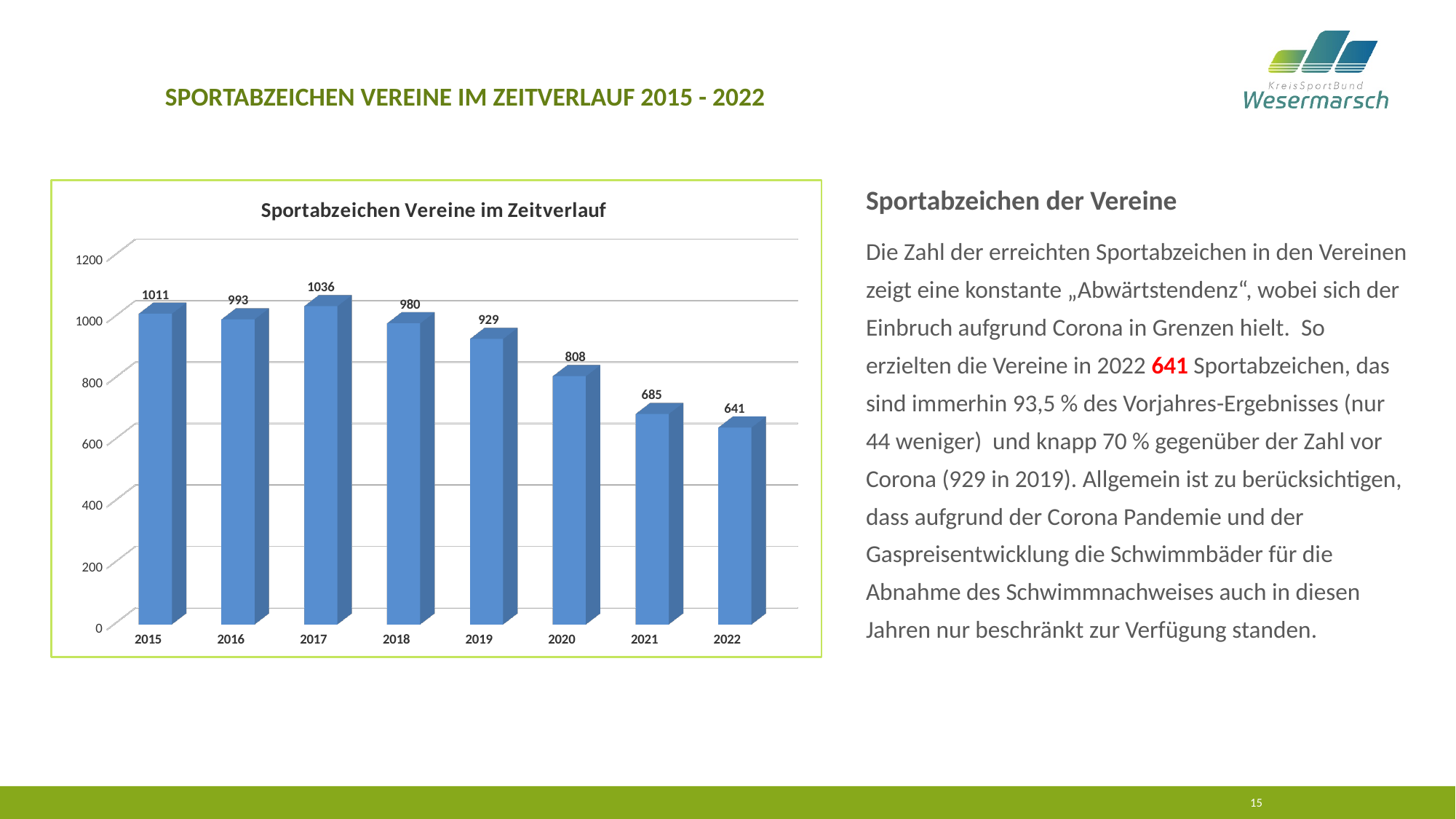
Is the value for 2021 greater or less than 800? less What is the value for 2020? 808 How many years are shown on the x axis? 8 What is the value for 2017? 1036 Which is larger, the value for 2019 or the value for 2020? 2019 Do the values generally rise or fall from 2017 to 2022? fall What is the difference between the values for 2015 and 2016? 18 What is the difference between the values for 2021 and 2022? 44 Which year has the highest value? 2017 What kind of chart is shown? bar chart What is the value for 2022? 641 Which year has the lowest value? 2022